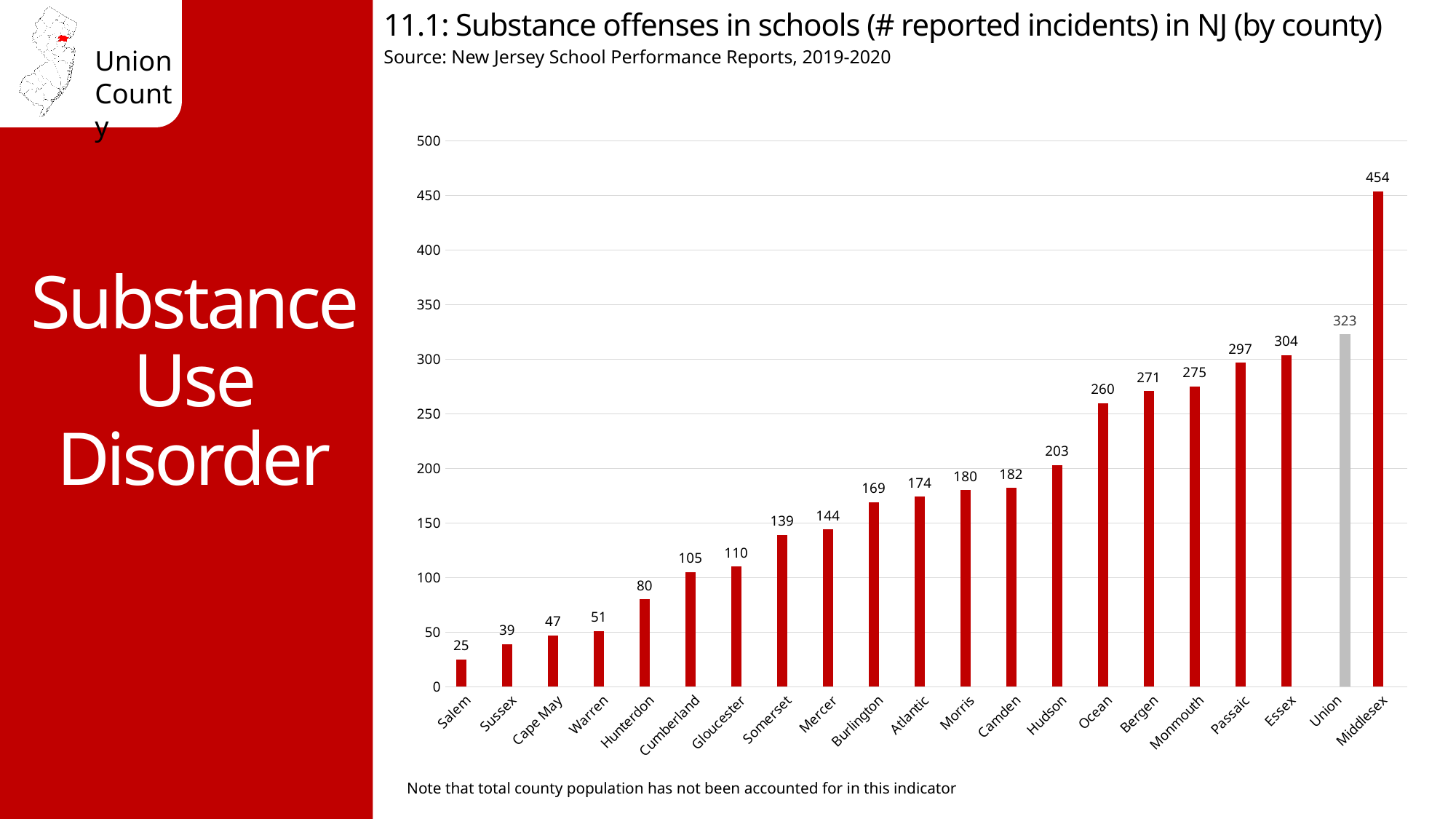
How many counties are shown on the chart? 21 What is the value shown for Hunterdon county? 80 Is the value for Hudson greater or less than 200? greater What is the difference between the values for Ocean and Bergen? 11 Do the values generally rise or fall from left to right along the x axis? Rise Which county's bar is coloured grey instead of red? Union Which county has a larger value, Essex or Passaic? Essex Which county has the lowest number of reported incidents? Salem What kind of chart is shown on the slide? Bar chart What is the number of reported substance offense incidents in schools for Union county? 323 Which county has the highest number of reported incidents? Middlesex What is the difference between the values for Middlesex and Union? 131